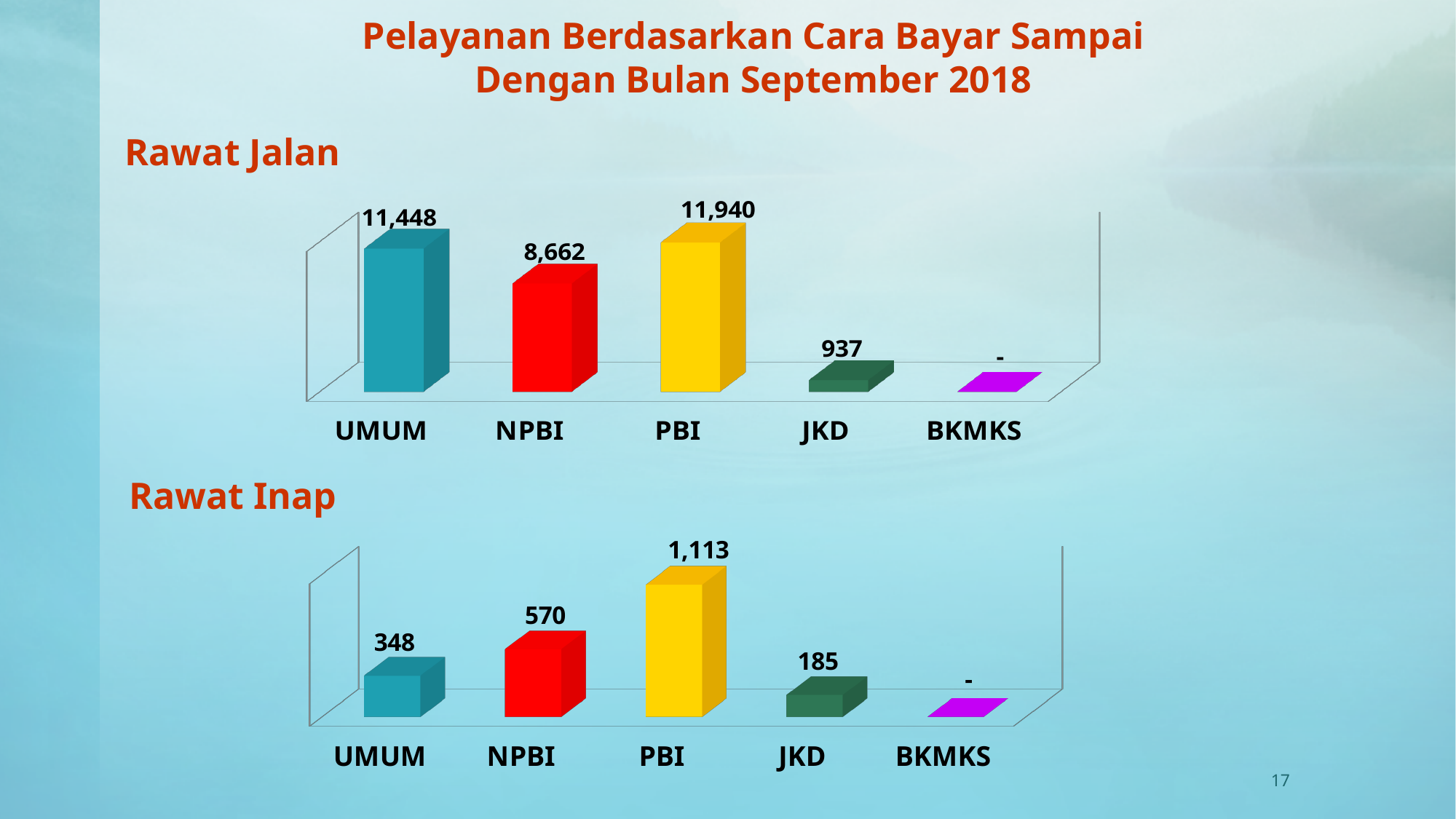
In the Rawat Inap chart, what is the value for PBI? 1,113 In the Rawat Jalan chart, what is the difference between the PBI and NPBI values? 3,278 In the Rawat Inap chart, which category has the lowest non-zero labelled value? JKD In the Rawat Jalan chart, which category has the highest value? PBI In the Rawat Inap chart, which is larger, the value for UMUM or the value for NPBI? NPBI What kind of chart is the Rawat Inap chart? Bar chart In the Rawat Jalan chart, what is the value for JKD? 937 In the Rawat Inap chart, what is the difference between the UMUM and JKD values? 163 In the Rawat Jalan chart, what is the value for UMUM? 11,448 In the Rawat Jalan chart, how many categories are shown on the x axis? 5 In the Rawat Inap chart, what is the value for NPBI? 570 In the Rawat Jalan chart, what label is shown above the BKMKS bar? -